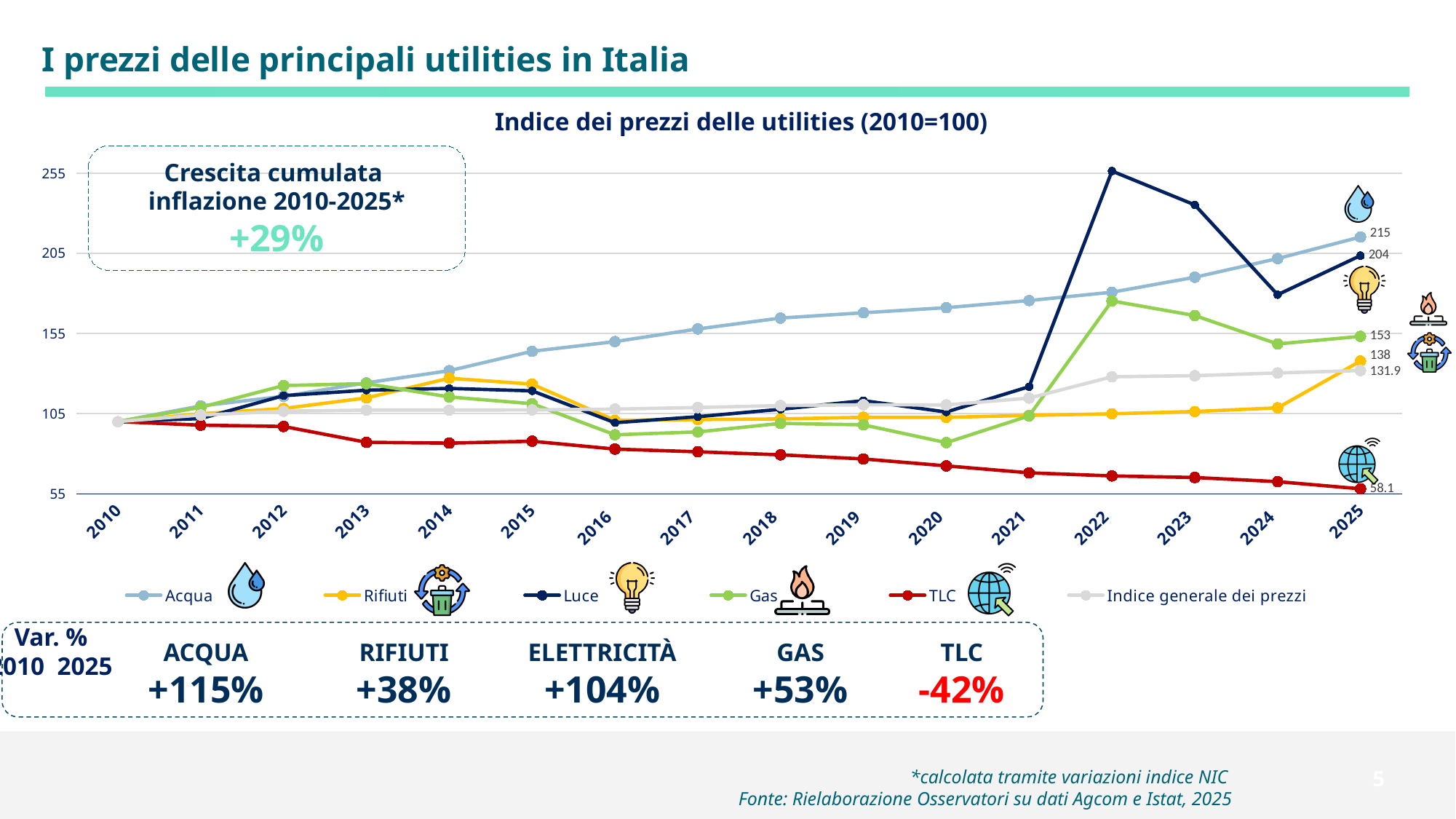
What is the value of the Acqua series in 2025? 215 What kind of chart is shown on the slide? Line chart Is the value for Luce in 2022 greater or less than 205? greater Does the TLC series rise or fall from 2010 to 2025? Fall What is the difference between the Acqua and Luce values in 2025? 11 In 2025, which is higher: Gas or Rifiuti? Gas What is the value of the Indice generale dei prezzi series in 2025? 131.9 What is the value of the TLC series in 2025? 58.1 How many series does the legend list? 6 What is the value of the Luce series in 2025? 204 What is the value of the Gas series in 2025? 153 Which series has the lowest value in 2025? TLC